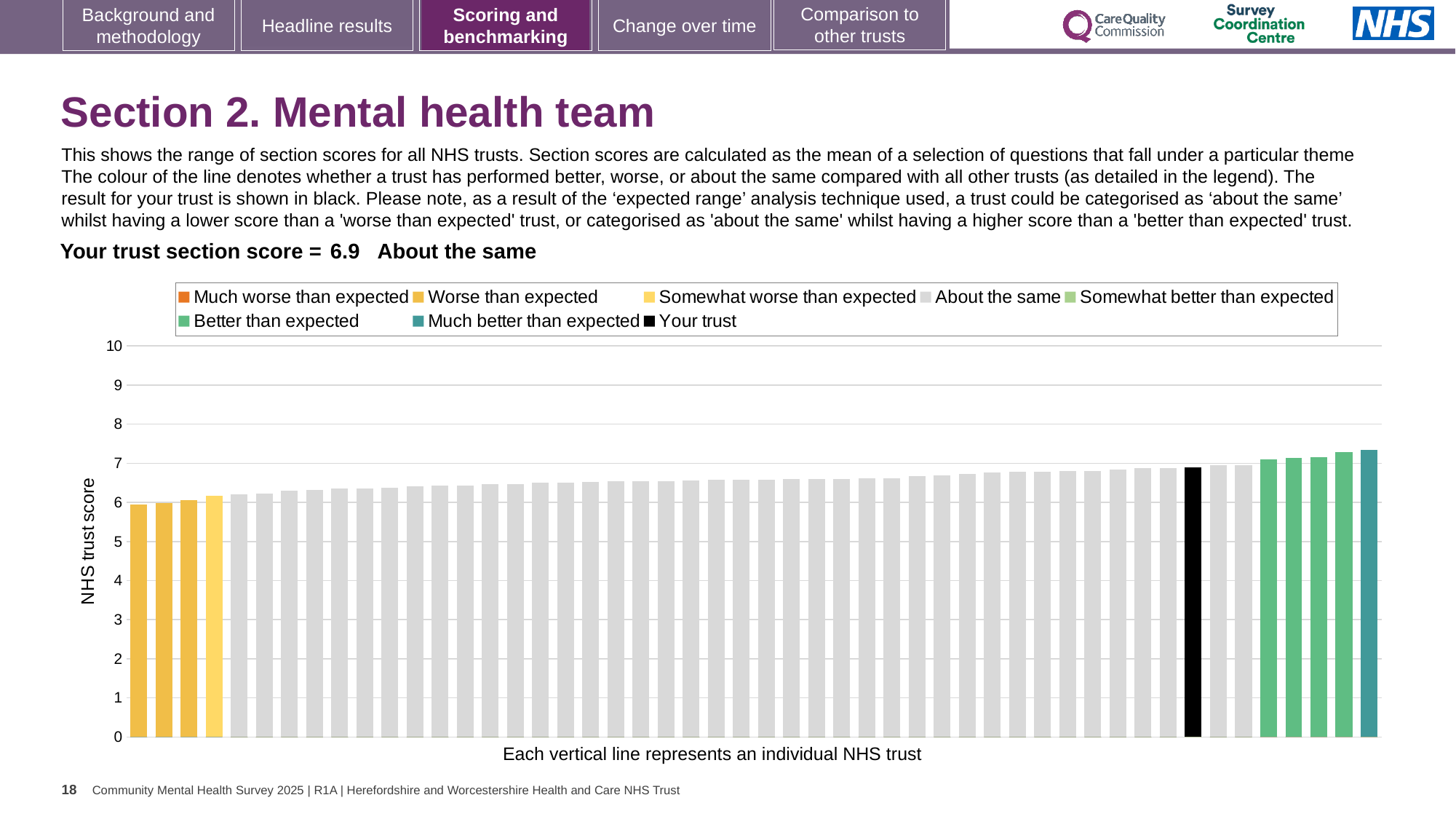
How many entries does the chart legend list? 8 Is the value of the shortest bar greater or less than 7? less Is the value of the tallest bar greater or less than 7? greater What is the label on the vertical axis? NHS trust score Is your trust's bar higher or lower than the rightmost bar? lower What kind of chart is shown on the slide? bar chart Is the value for your trust greater or less than 6? greater How many bars are coloured as 'Better than expected' (green)? 4 Which category is your trust placed in for this section? About the same Which legend category does the tallest bar belong to? Much better than expected What is the section score for your trust shown on the slide? 6.9 Do the bar values rise or fall from left to right along the x axis? rise